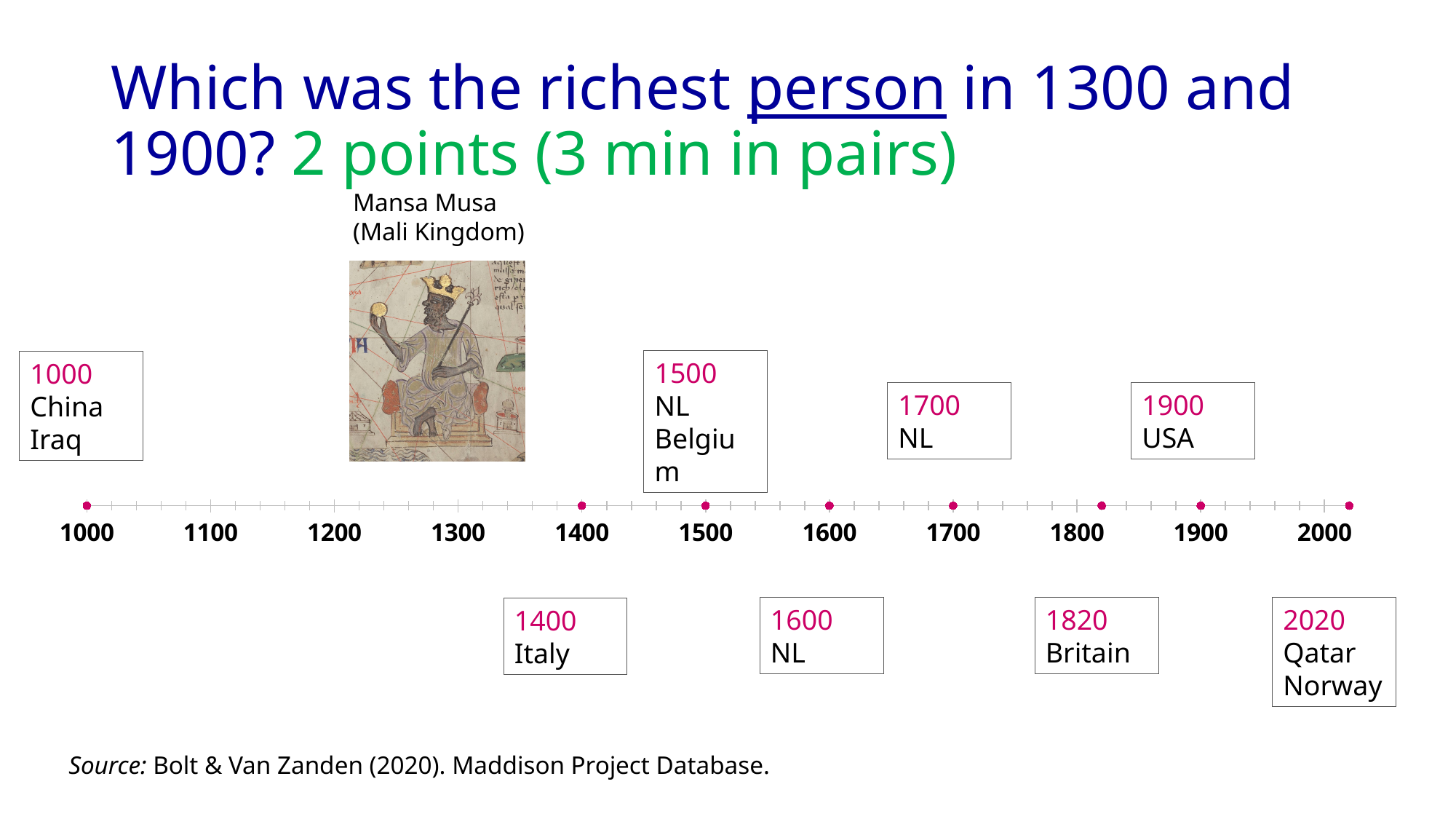
Who is shown in the picture above the timeline? Mansa Musa (Mali Kingdom) In which year is Britain labelled on the timeline? 1820 What is the earliest year marked with a point on the timeline? 1000 What kind of chart is shown on the slide? A timeline Which countries are labelled at the year 2020 on the timeline? Qatar and Norway Which country is labelled at the year 1900 on the timeline? USA What is the latest year marked with a point on the timeline? 2020 How many points are marked on the timeline? 8 Which country is labelled at the year 1400 on the timeline? Italy Which country is labelled at the year 1700 on the timeline? NL Which countries are labelled at the year 1000 on the timeline? China and Iraq Which countries are labelled at the year 1500 on the timeline? NL and Belgium